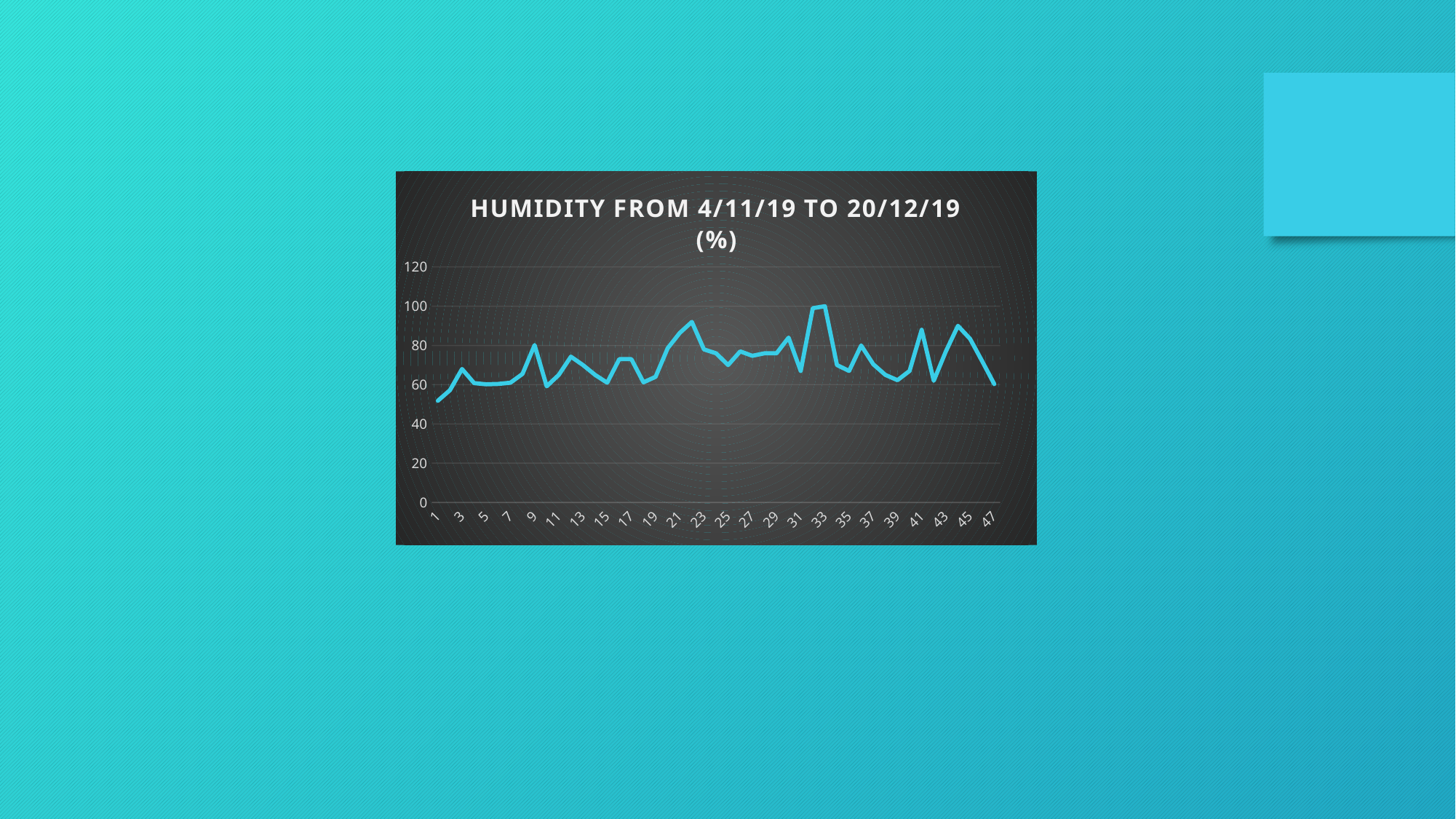
What is the highest value shown on the y axis? 120 Does the humidity value rise or fall from point 45 to point 47? fall Is the humidity value at point 21 greater or less than 80? greater What kind of chart is shown on the slide? line chart What is the title of the chart? HUMIDITY FROM 4/11/19 TO 20/12/19 (%) Which has the higher humidity value, point 33 or point 1? point 33 Is the humidity value at point 39 greater or less than 80? less Is the humidity value at point 1 greater or less than 60? less How many data points are plotted along the x axis? 47 Which x-axis point has the lowest humidity value? 1